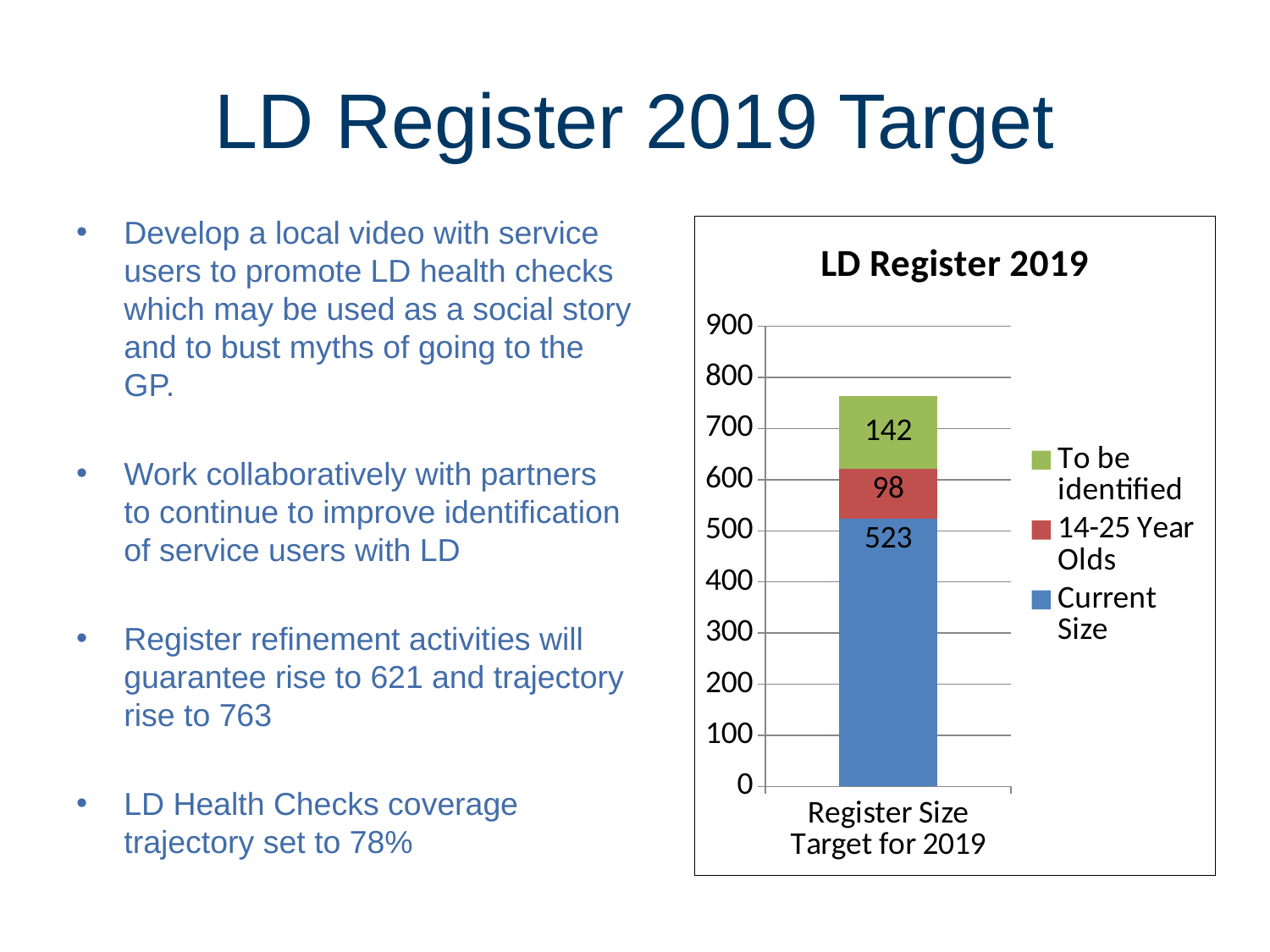
What kind of chart is shown on the slide? Stacked bar chart What is the value of the Current Size segment in the LD Register 2019 chart? 523 How many series does the legend list? 3 Which segment of the stacked bar has the smallest value? 14-25 Year Olds Which segment of the stacked bar has the largest value? Current Size What is the title of the chart? LD Register 2019 Which is larger, the To be identified segment or the 14-25 Year Olds segment? To be identified What is the value of the To be identified segment in the LD Register 2019 chart? 142 Is the total of the stacked bar greater or less than 800? less What is the total height of the stacked bar for Register Size Target for 2019? 763 What is the difference between the Current Size value and the To be identified value? 381 What is the value of the 14-25 Year Olds segment in the LD Register 2019 chart? 98